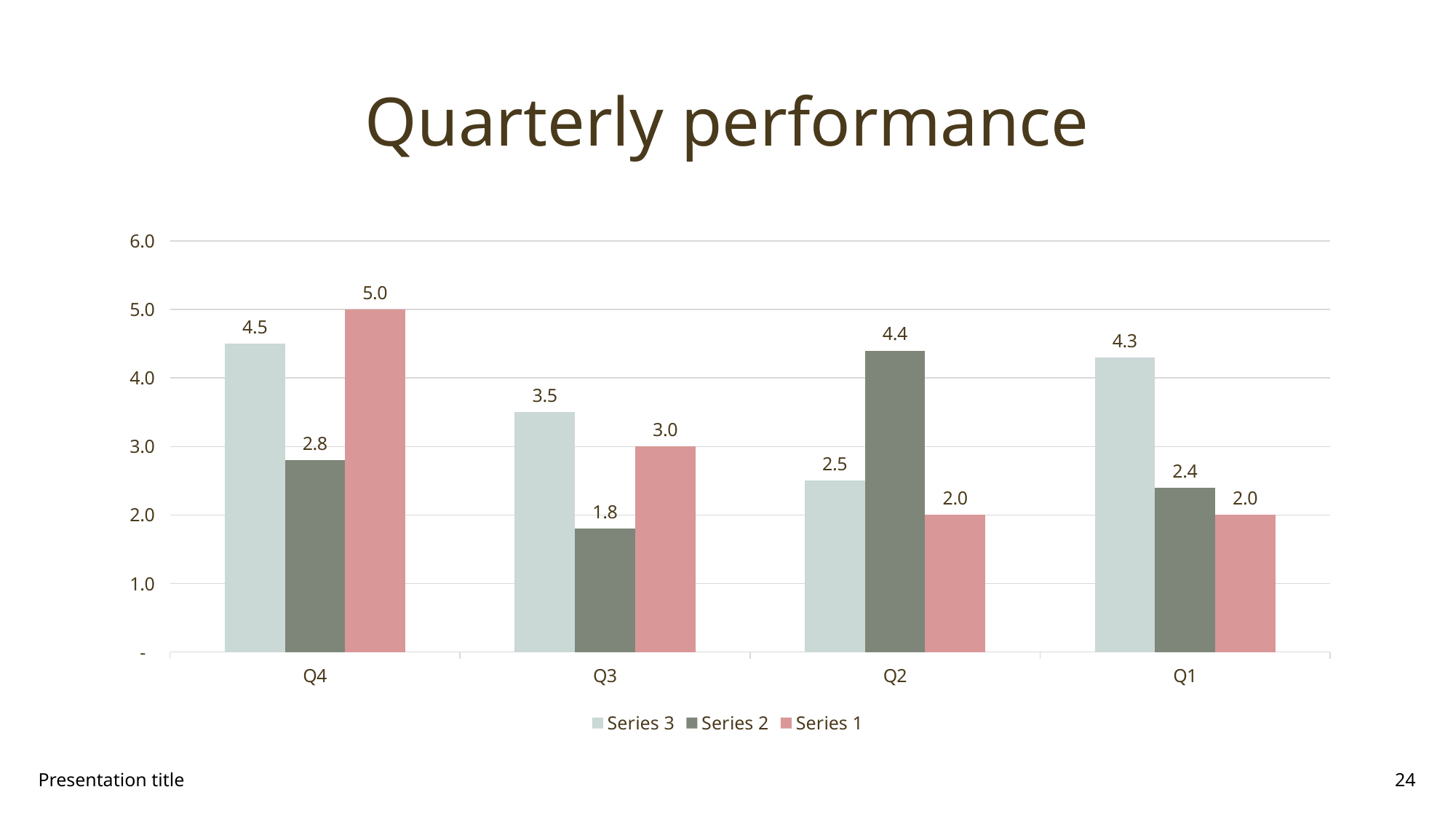
What is the value of Series 3 for Q1? 4.3 What is the title of the chart? Quarterly performance How many quarters are shown on the x axis? 4 What is the value of Series 2 for Q3? 1.8 Which is larger for Q3: Series 3 or Series 1? Series 3 How many series does the legend list? 3 Which quarter has the highest value for Series 2? Q2 What is the difference between Series 1 and Series 2 for Q4? 2.2 Is the value for Series 2 in Q2 greater or less than 4.0? greater What kind of chart is shown on the slide? Bar chart What is the value of Series 1 for Q4? 5.0 Which quarter has the lowest value for Series 3? Q2